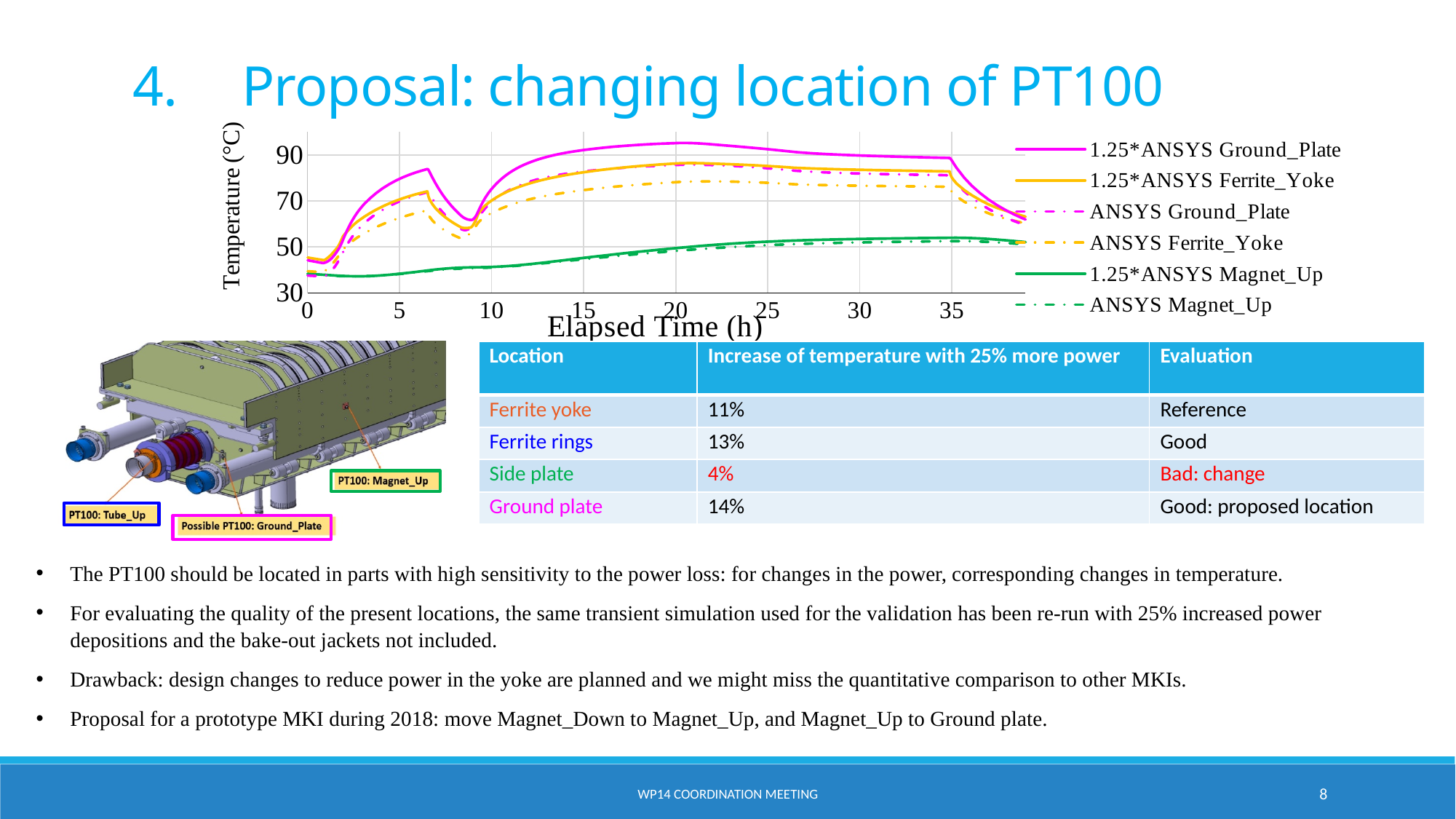
At 20 h, which series has the larger value: 1.25*ANSYS Ground_Plate or 1.25*ANSYS Magnet_Up? 1.25*ANSYS Ground_Plate Is the value of the ANSYS Magnet_Up series at 35 h greater or less than 70? less How many series does the chart legend list? 6 Does the 1.25*ANSYS Ground_Plate series rise or fall between 10 h and 20 h? rise What is the title of the chart's x axis? Elapsed Time (h) Which series reaches the highest temperature on the chart? 1.25*ANSYS Ground_Plate Does the 1.25*ANSYS Ferrite_Yoke series rise or fall between 35 h and the end of the chart? fall Is the value of the 1.25*ANSYS Magnet_Up series at 0 h greater or less than 50? less Is the value of the 1.25*ANSYS Ferrite_Yoke series at 20 h greater or less than 70? greater What kind of chart is shown on the slide? line chart What is the title of the chart's y axis? Temperature (°C)